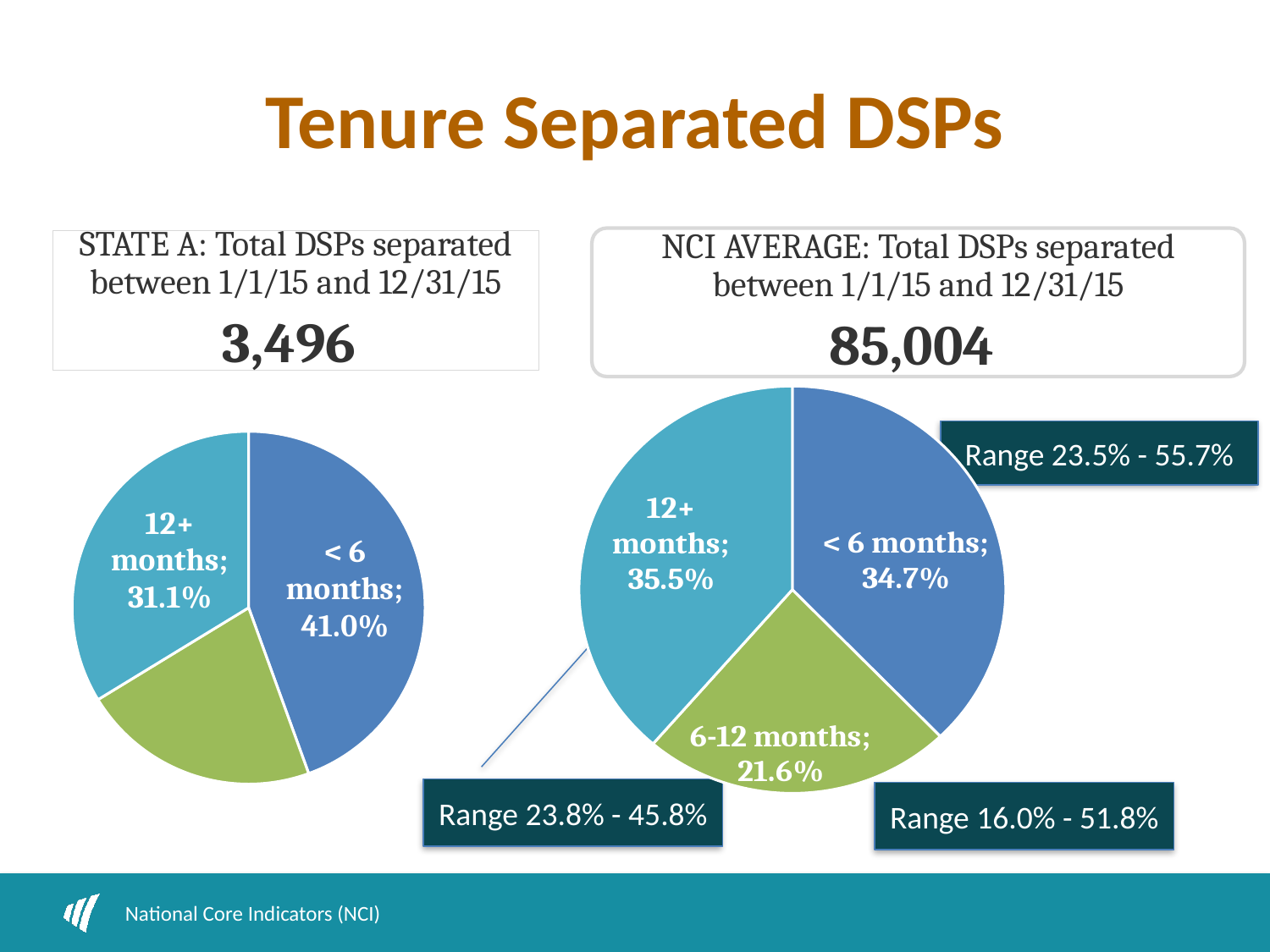
How many slices does the NCI AVERAGE pie chart have? 3 On the NCI AVERAGE chart, what range is shown in the box next to the < 6 months slice? Range 23.5% - 55.7% In the STATE A pie chart, which tenure category has the largest slice? < 6 months In the NCI AVERAGE pie chart, which tenure category has the smallest slice? 6-12 months What kind of chart is the STATE A chart on the left? pie chart In the STATE A pie chart, what share of separated DSPs had tenure of 12+ months? 31.1% In the NCI AVERAGE pie chart, which is larger: the 12+ months slice or the < 6 months slice? 12+ months In the STATE A pie chart, how many percentage points larger is the < 6 months slice than the 12+ months slice? 9.9 percentage points In the NCI AVERAGE pie chart, what share of separated DSPs had tenure of < 6 months? 34.7% In the NCI AVERAGE pie chart, what share of separated DSPs had tenure of 6-12 months? 21.6% In the STATE A pie chart, what share of separated DSPs had tenure of < 6 months? 41.0% In the NCI AVERAGE pie chart, what share of separated DSPs had tenure of 12+ months? 35.5%